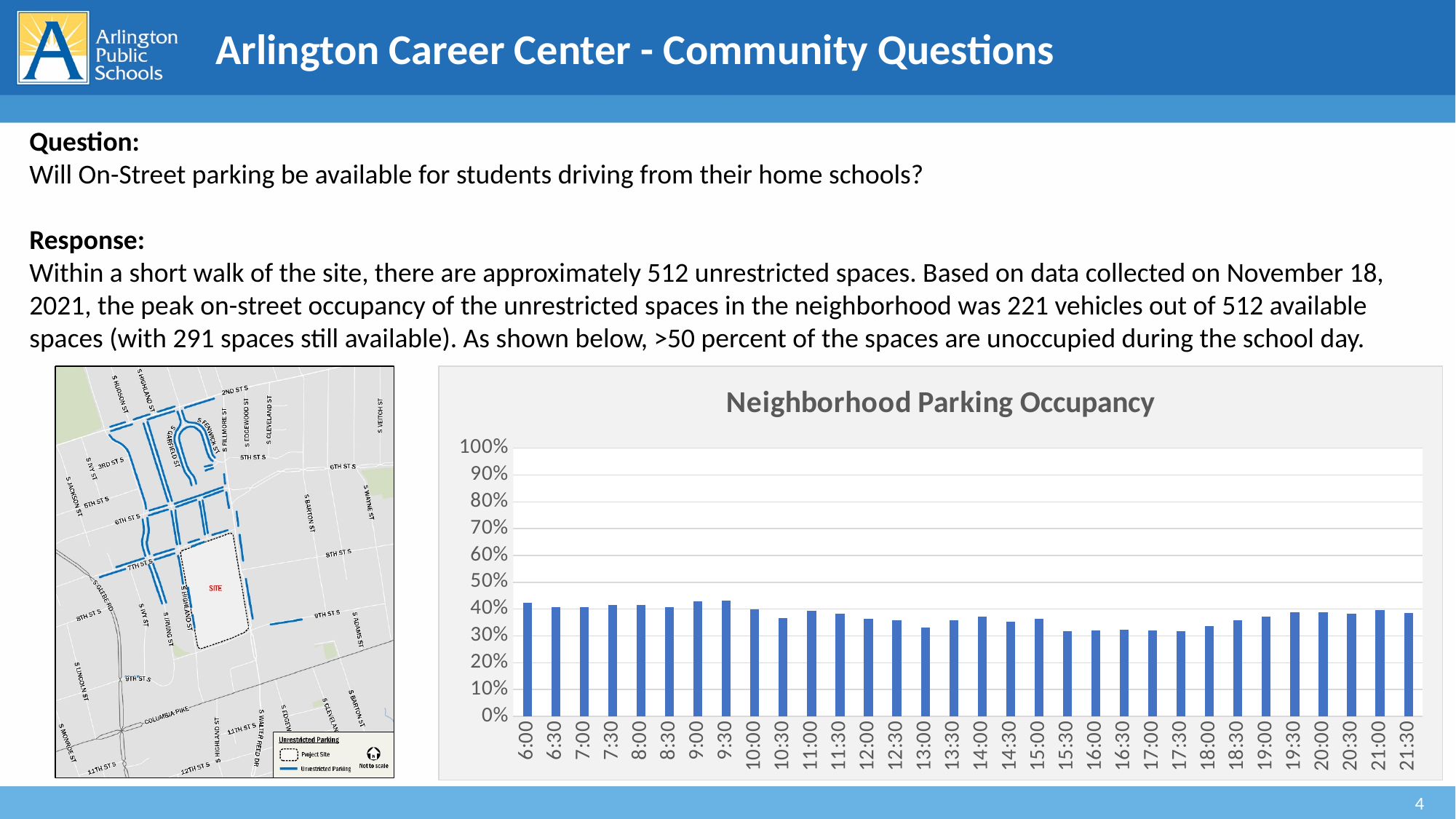
Which has higher parking occupancy, 6:00 or 13:00? 6:00 What is the highest value shown on the y axis of the chart? 100% How many time points are plotted along the x axis of the chart? 32 Which has higher parking occupancy, 9:30 or 15:30? 9:30 What type of chart is shown on the slide? bar chart What is the title of the chart? Neighborhood Parking Occupancy Is the parking occupancy at 9:30 greater or less than 50%? less Do the parking occupancy values generally rise or fall from 9:30 to 15:30? fall Is the parking occupancy at 10:30 greater or less than 40%? less Is the parking occupancy at 13:00 greater or less than 40%? less